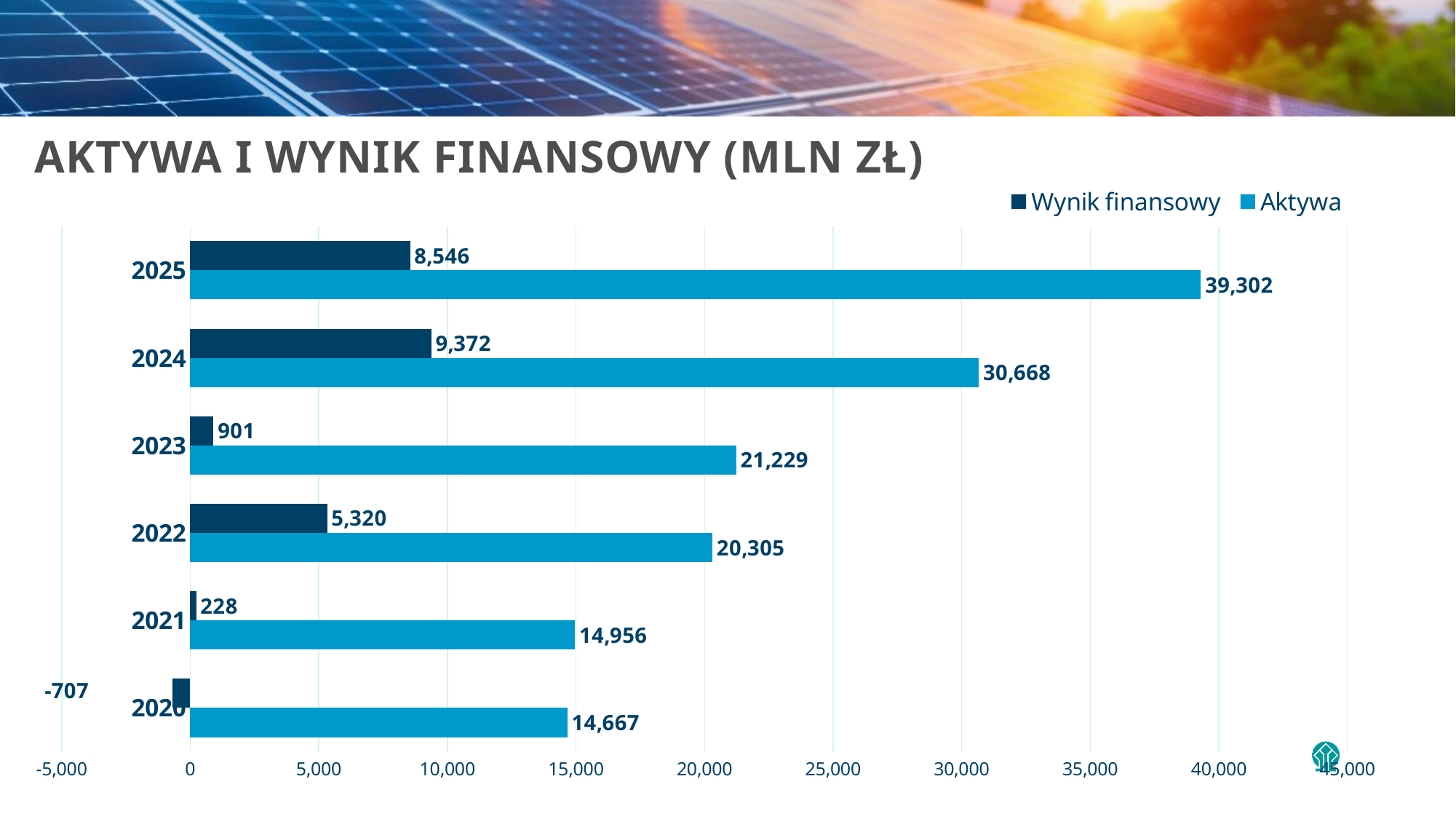
How many years are shown on the chart? 6 What is the value of Wynik finansowy for 2020? -707 What is the value of Aktywa for 2021? 14,956 What is the difference between Aktywa in 2025 and Aktywa in 2024? 8,634 Which year has the lowest Wynik finansowy value? 2020 What is the value of Aktywa for 2025? 39,302 Which is larger: Wynik finansowy in 2024 or Wynik finansowy in 2025? Wynik finansowy in 2024 How many series does the legend list? 2 What is the title of the chart? AKTYWA I WYNIK FINANSOWY (MLN ZŁ) What is the value of Wynik finansowy for 2024? 9,372 What kind of chart is shown on the slide? Bar chart Which year has the highest Aktywa value? 2025